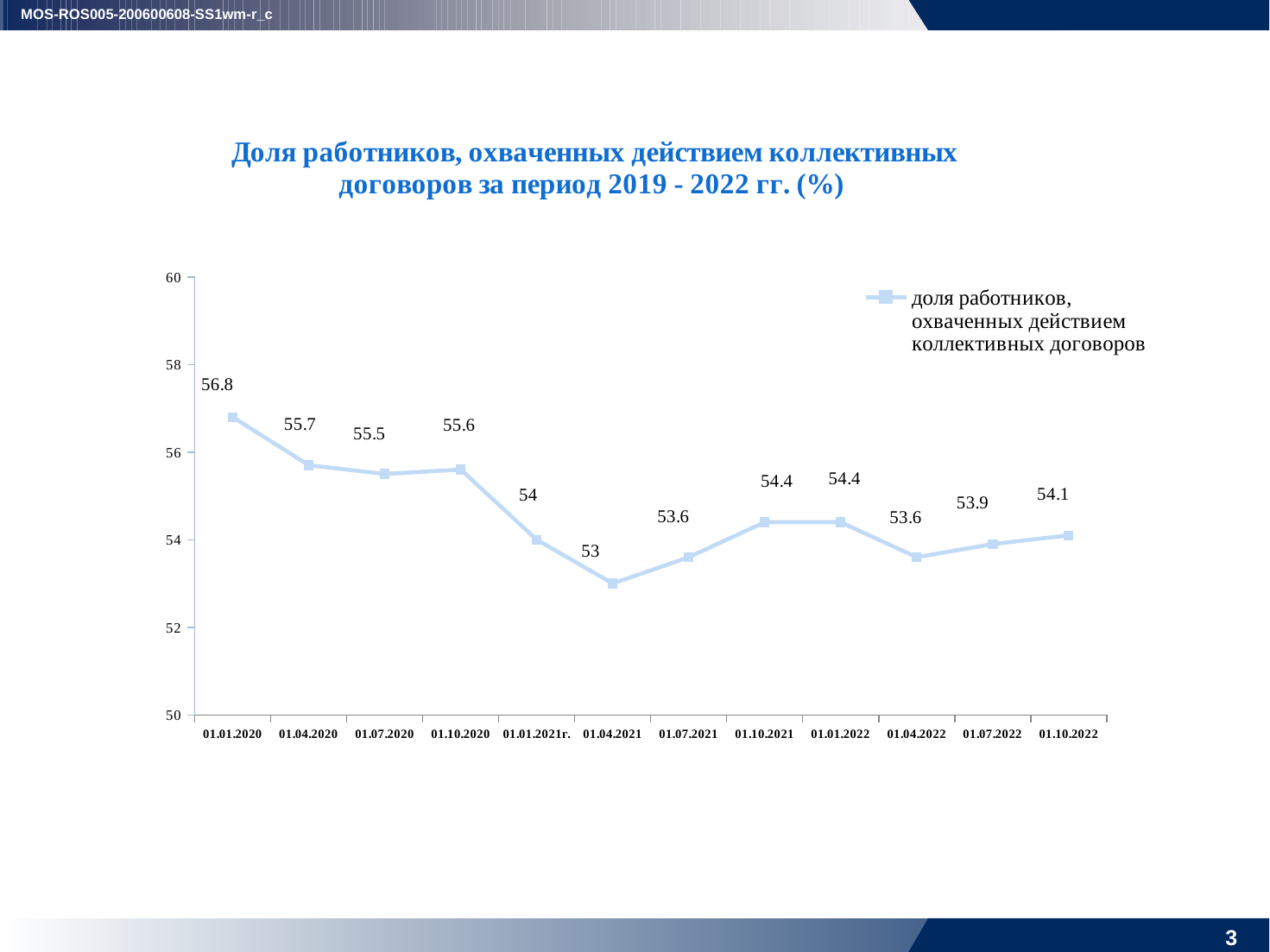
Which date has the highest value? 01.01.2020 What is the value for 01.04.2021? 53 Do the values rise or fall from 01.01.2020 to 01.04.2021? fall What is the value for 01.10.2022? 54.1 What is the value for 01.01.2020? 56.8 What is the difference between the values for 01.01.2020 and 01.04.2021? 3.8 Which is larger, the value for 01.10.2020 or the value for 01.07.2022? 01.10.2020 How many data points are plotted on the chart? 12 Is the value for 01.04.2020 greater or less than 56? less What kind of chart is shown on the slide? line chart Which date has the lowest value? 01.04.2021 How many series does the legend list? 1